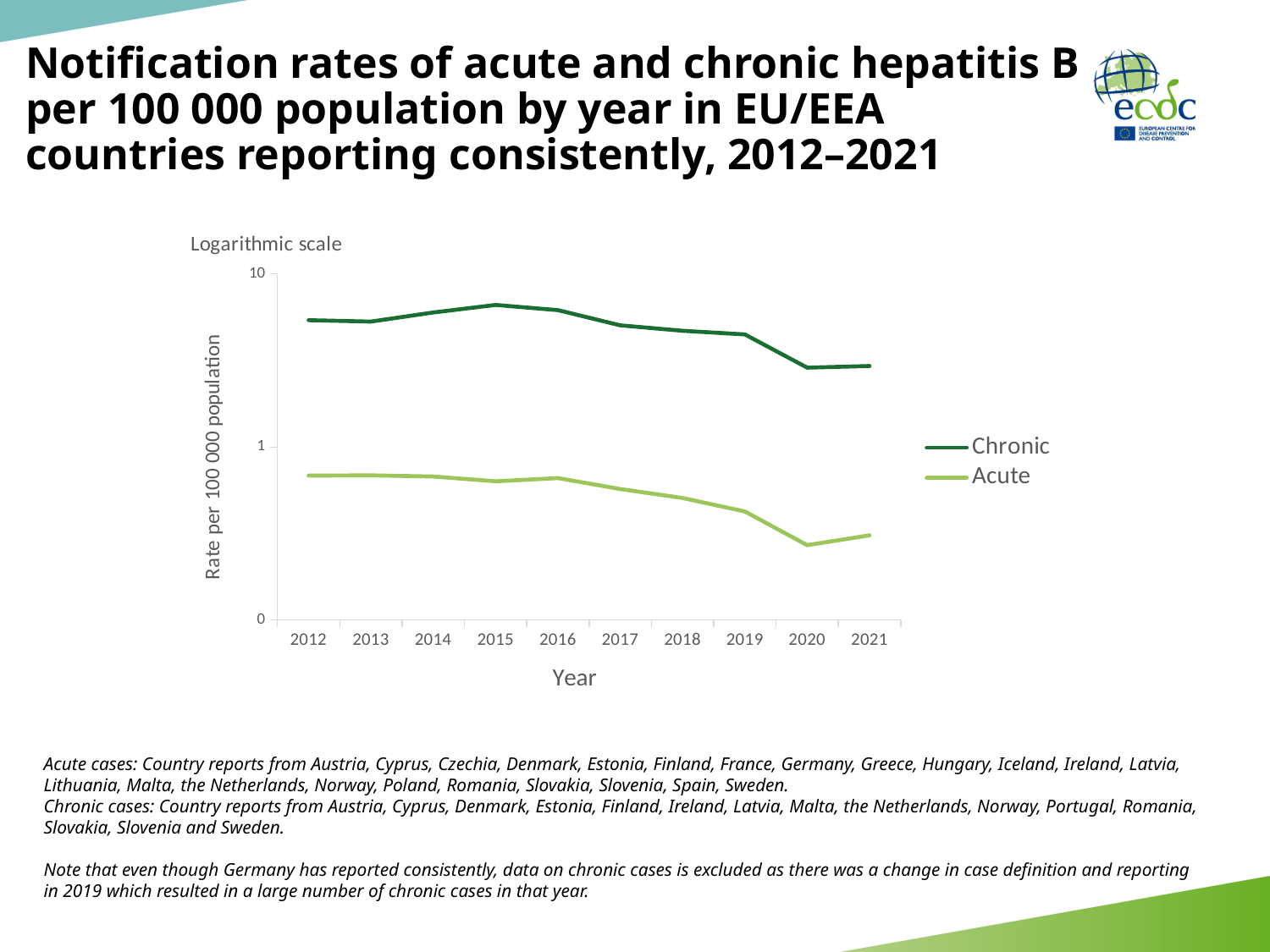
Which series has the higher notification rate in 2019, Chronic or Acute? Chronic Is the Chronic notification rate in 2020 greater or less than 10? less How many years are shown along the x axis? 10 In which year is the Acute notification rate lowest? 2020 How many series does the legend list? 2 What scale is used for the y axis, according to the label above the chart? Logarithmic scale Does the Acute notification rate generally rise or fall from 2012 to 2020? Fall Is the Chronic notification rate in 2012 greater or less than 1? greater Is the Acute notification rate in 2021 greater or less than 1? less Does the Chronic notification rate rise or fall between 2016 and 2020? Fall What kind of chart is shown on the slide? Line chart Which two series are listed in the legend? Chronic and Acute